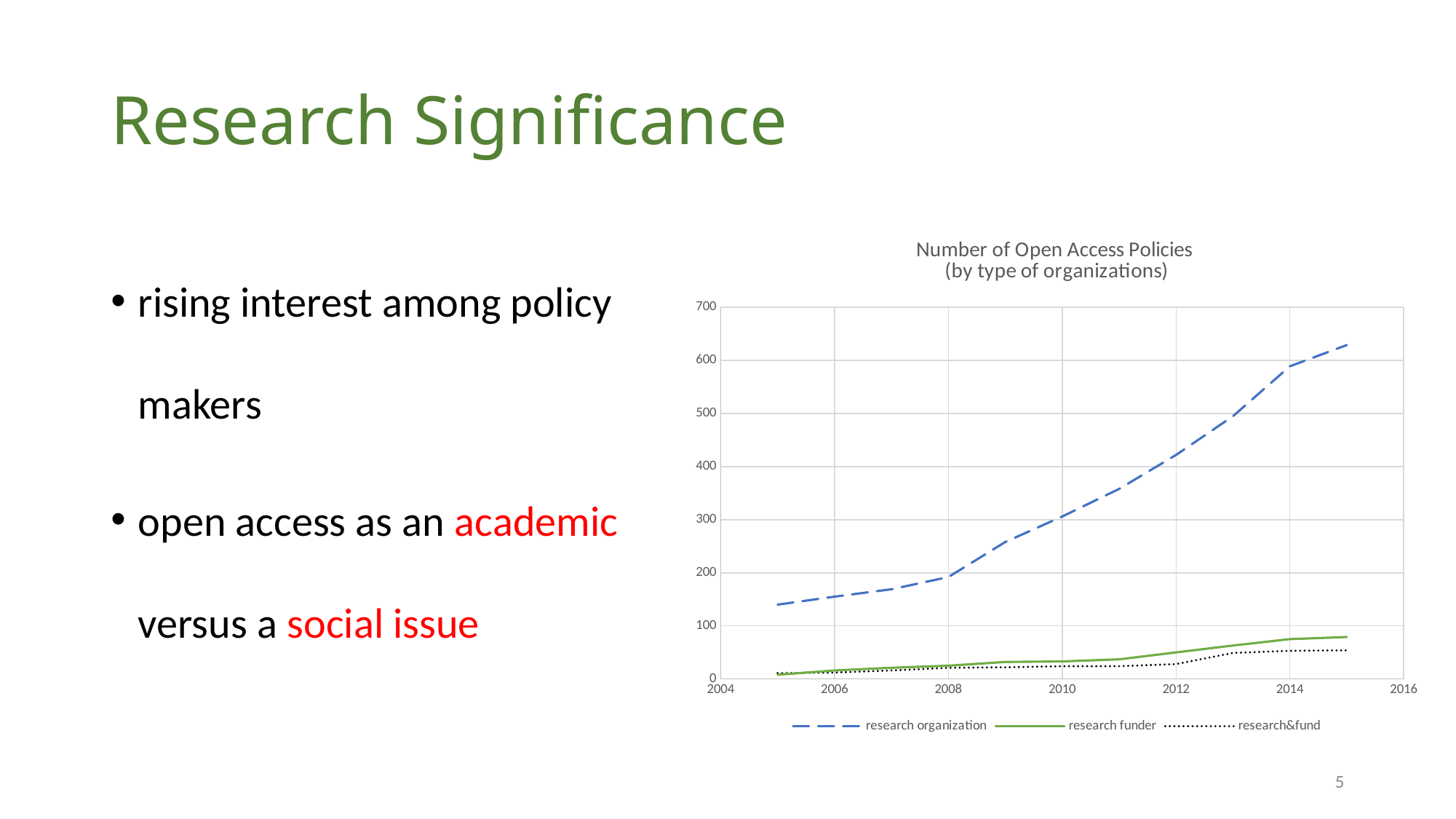
What is the title of the chart? Number of Open Access Policies (by type of organizations) What kind of chart is shown on the slide? line chart Which series has the lowest values across the chart? research&fund Is the value for research funder in 2015 greater or less than 100? less Does the research organization series rise or fall from 2005 to 2015? rise How many series does the legend list? 3 Is the value for research organization in 2015 greater or less than 600? greater Which series is drawn as a solid green line? research funder Which is larger in 2014: research organization or research funder? research organization Which series has the highest values across the chart? research organization